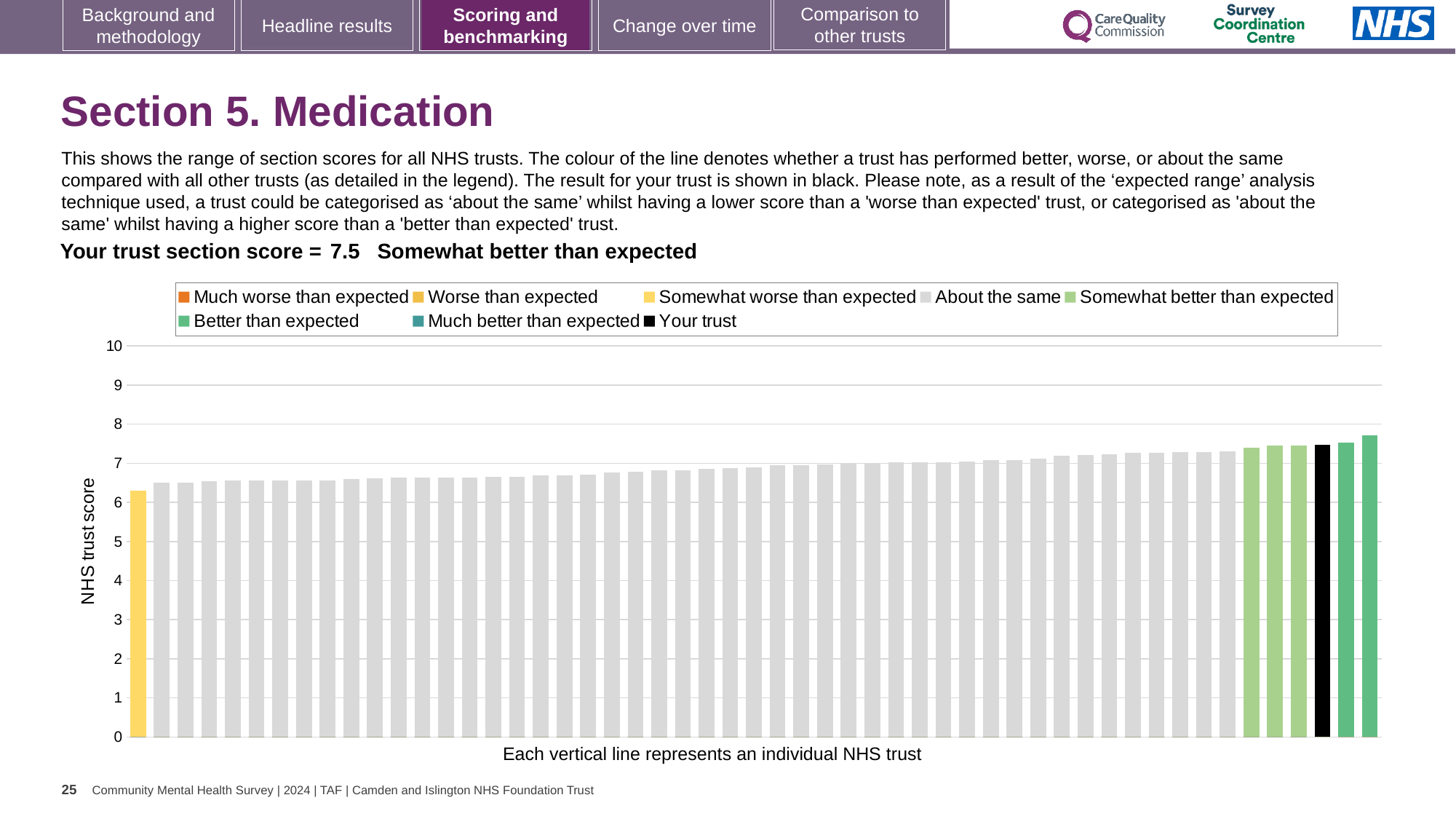
Is the value of the highest bar on the far right greater or less than 8? less What is the title of the y axis? NHS trust score Is the value for your trust (the black bar) greater or less than 7? greater What kind of chart is shown on the slide? bar chart How many entries does the chart legend list? 8 Which is larger: the black bar for your trust or the yellow bar on the far left? the black bar for your trust What is the section score for your trust shown on the slide? 7.5 Do the bar values rise or fall from left to right along the x axis? rise How many bars are coloured light green (Somewhat better than expected)? 3 What colour is the bar representing your trust? black Is the value of the lowest bar (the yellow bar on the far left) greater or less than 6? greater